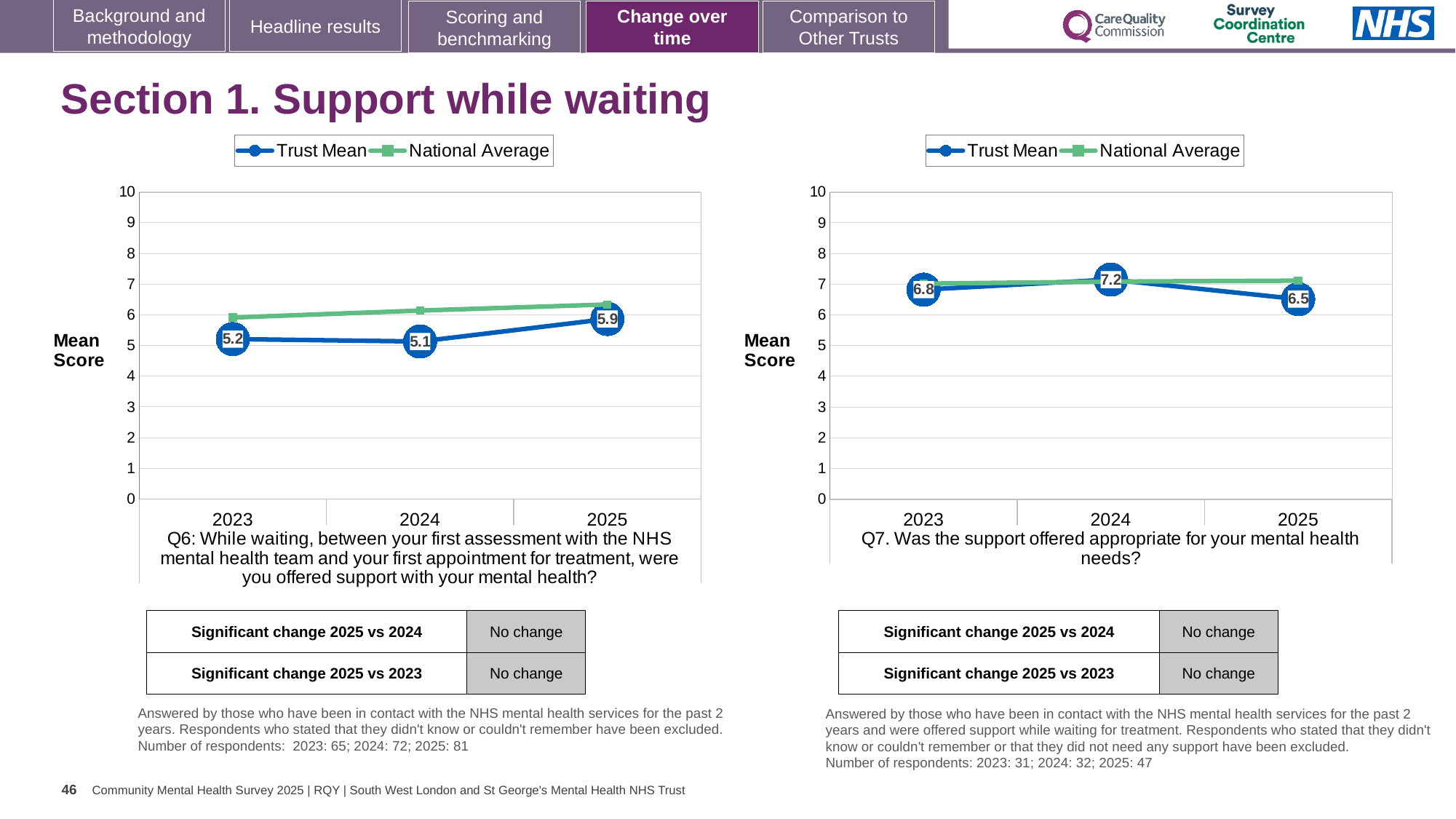
How many series does the legend of the left chart (Q6) list? 2 In the right chart (Q7), what is the Trust Mean for 2025? 6.5 In the left chart (Q6), what is the difference between the Trust Mean for 2025 and 2024? 0.8 In the left chart (Q6), is the Trust Mean for 2023 greater or less than 6? less In the left chart (Q6), which year has the lowest Trust Mean? 2024 In the right chart (Q7), which year has the highest Trust Mean? 2024 In the right chart (Q7), what is the Trust Mean for 2024? 7.2 In the left chart (Q6), what is the Trust Mean for 2023? 5.2 In the left chart (Q6), what is the Trust Mean for 2025? 5.9 In the right chart (Q7), is the National Average for 2024 greater or less than 6? greater In the right chart (Q7), what is the difference between the Trust Mean for 2024 and 2025? 0.7 What type of chart is the right chart (Q7)? Line chart